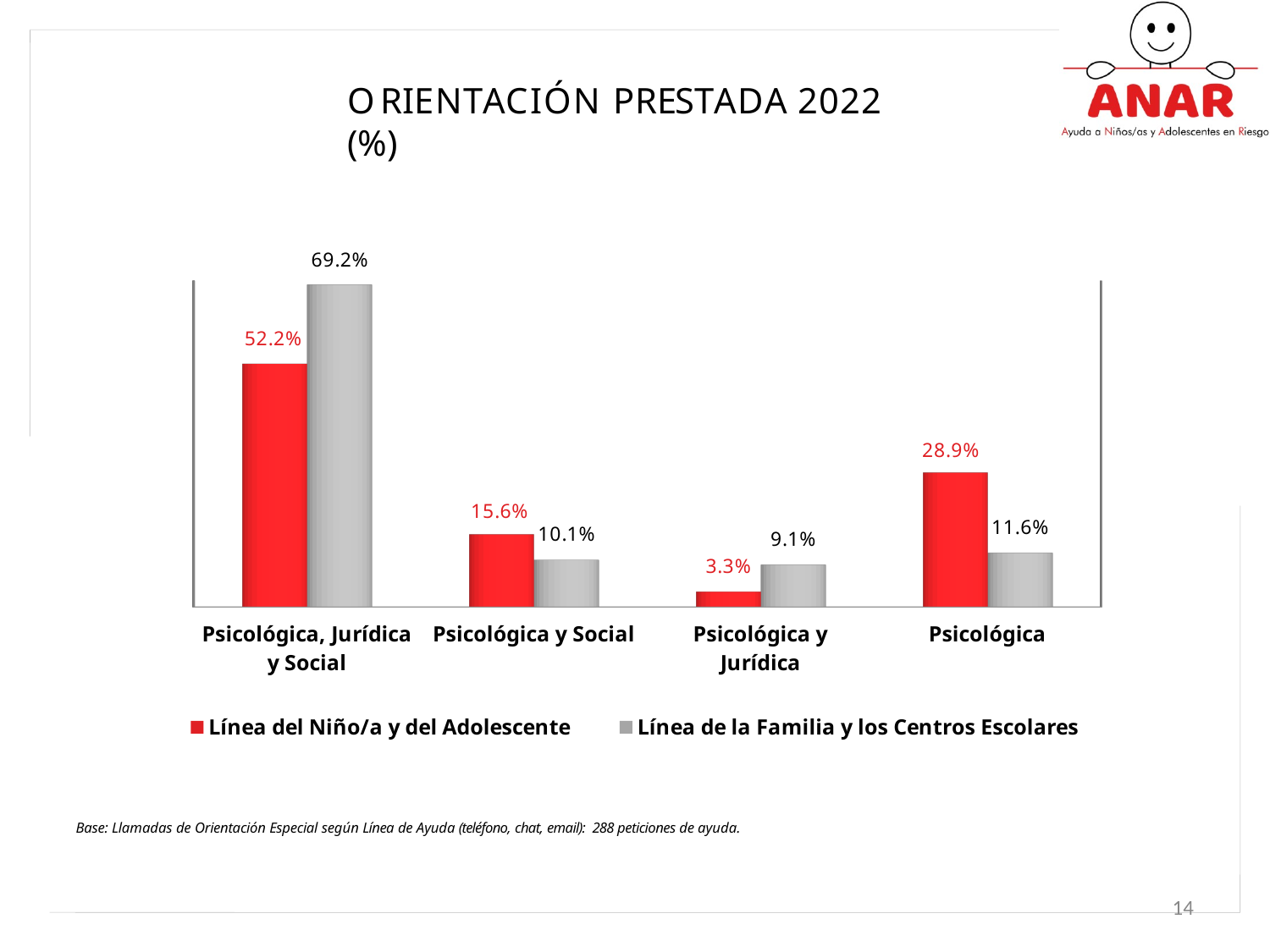
For Psicológica y Jurídica, which series has the larger value? Línea de la Familia y los Centros Escolares What kind of chart is shown on the slide? Bar chart How many categories are shown on the x axis? 4 What is the value for Psicológica in the Línea de la Familia y los Centros Escolares series? 11.6% Which category has the highest value in the Línea de la Familia y los Centros Escolares series? Psicológica, Jurídica y Social Which category has the lowest value in the Línea del Niño/a y del Adolescente series? Psicológica y Jurídica For Psicológica y Social, which series has the larger value? Línea del Niño/a y del Adolescente How many series does the legend list? 2 What is the difference between the two series for Psicológica? 17.3% What is the value for Psicológica, Jurídica y Social in the Línea del Niño/a y del Adolescente series? 52.2% What is the value for Psicológica y Jurídica in the Línea del Niño/a y del Adolescente series? 3.3% What is the difference between the two series for Psicológica, Jurídica y Social? 17.0%